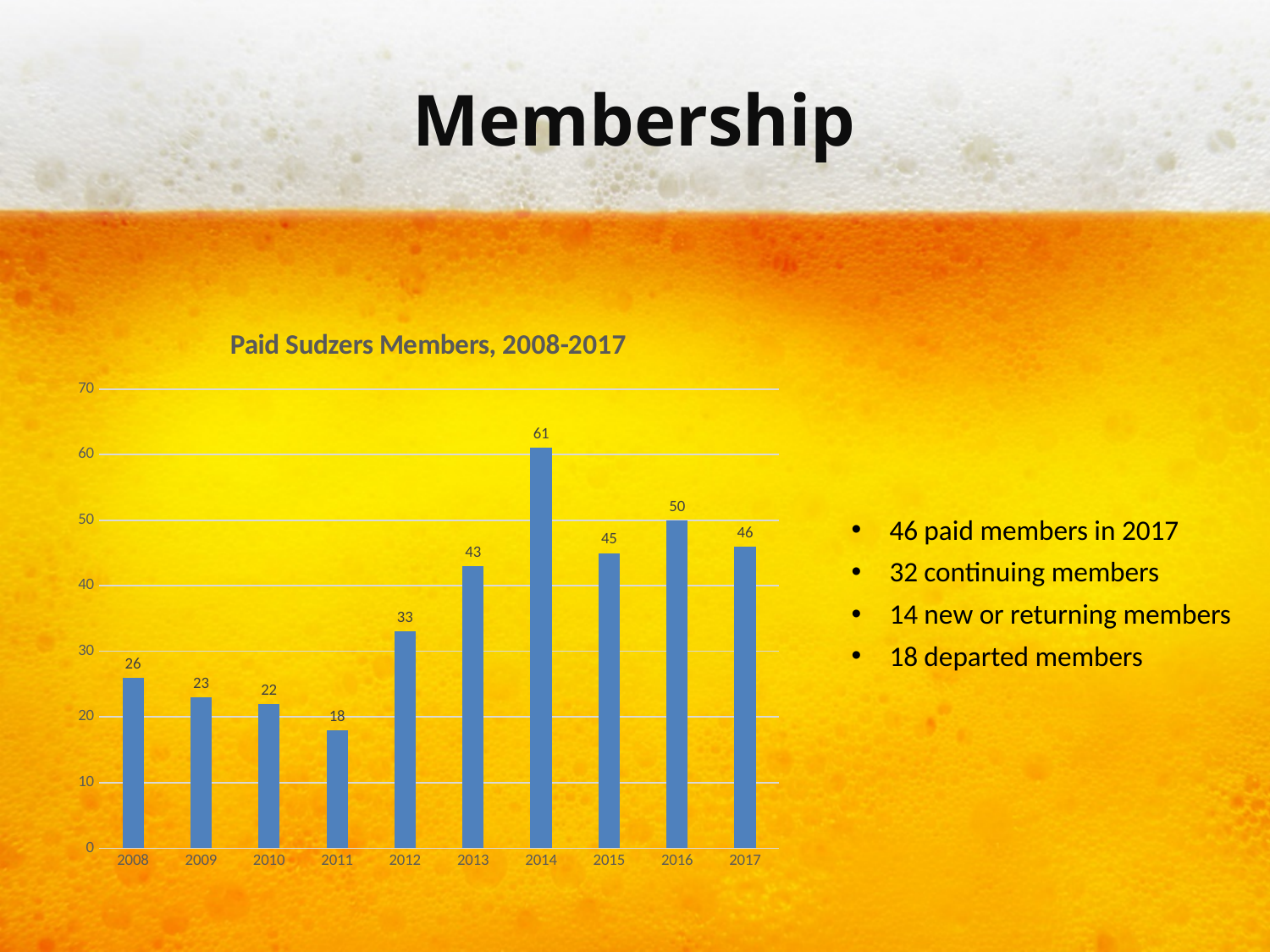
Which year has the lowest number of paid members? 2011 How many years are shown on the x axis? 10 What is the value for 2011? 18 What is the difference between the values for 2014 and 2017? 15 What is the difference between the values for 2012 and 2011? 15 What is the value for 2014? 61 Which is larger, the value for 2016 or the value for 2015? 2016 What is the value for 2017? 46 What is the title of the chart? Paid Sudzers Members, 2008-2017 Which year has the highest number of paid members? 2014 Is the value for 2013 greater or less than 40? greater What kind of chart is shown on the slide? bar chart